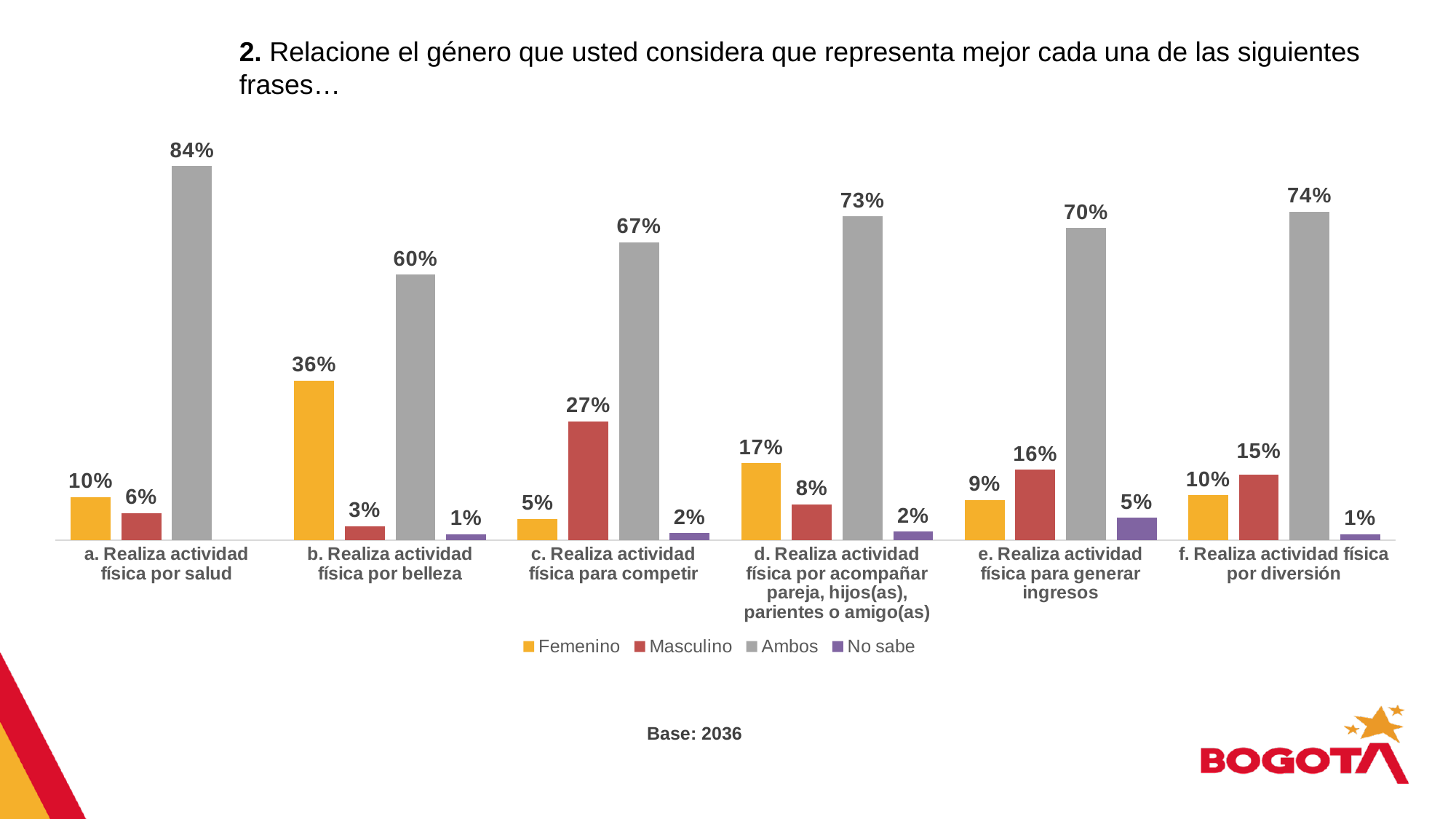
How many categories are shown on the x axis? 6 What is the value for Masculino in category c. Realiza actividad física para competir? 27% What is the value for Ambos in category a. Realiza actividad física por salud? 84% What is the value for Femenino in category b. Realiza actividad física por belleza? 36% What base (sample size) is stated below the chart? 2036 How many series does the legend list? 4 Which category has the highest value for Ambos? a. Realiza actividad física por salud What is the difference between the Ambos values for a. Realiza actividad física por salud and b. Realiza actividad física por belleza? 24% What kind of chart is shown on the slide? Bar chart What is the value for No sabe in category e. Realiza actividad física para generar ingresos? 5% Which is larger in category d. Realiza actividad física por acompañar pareja, hijos(as), parientes o amigo(as): Femenino or Masculino? Femenino Which category has the lowest value for Femenino? c. Realiza actividad física para competir